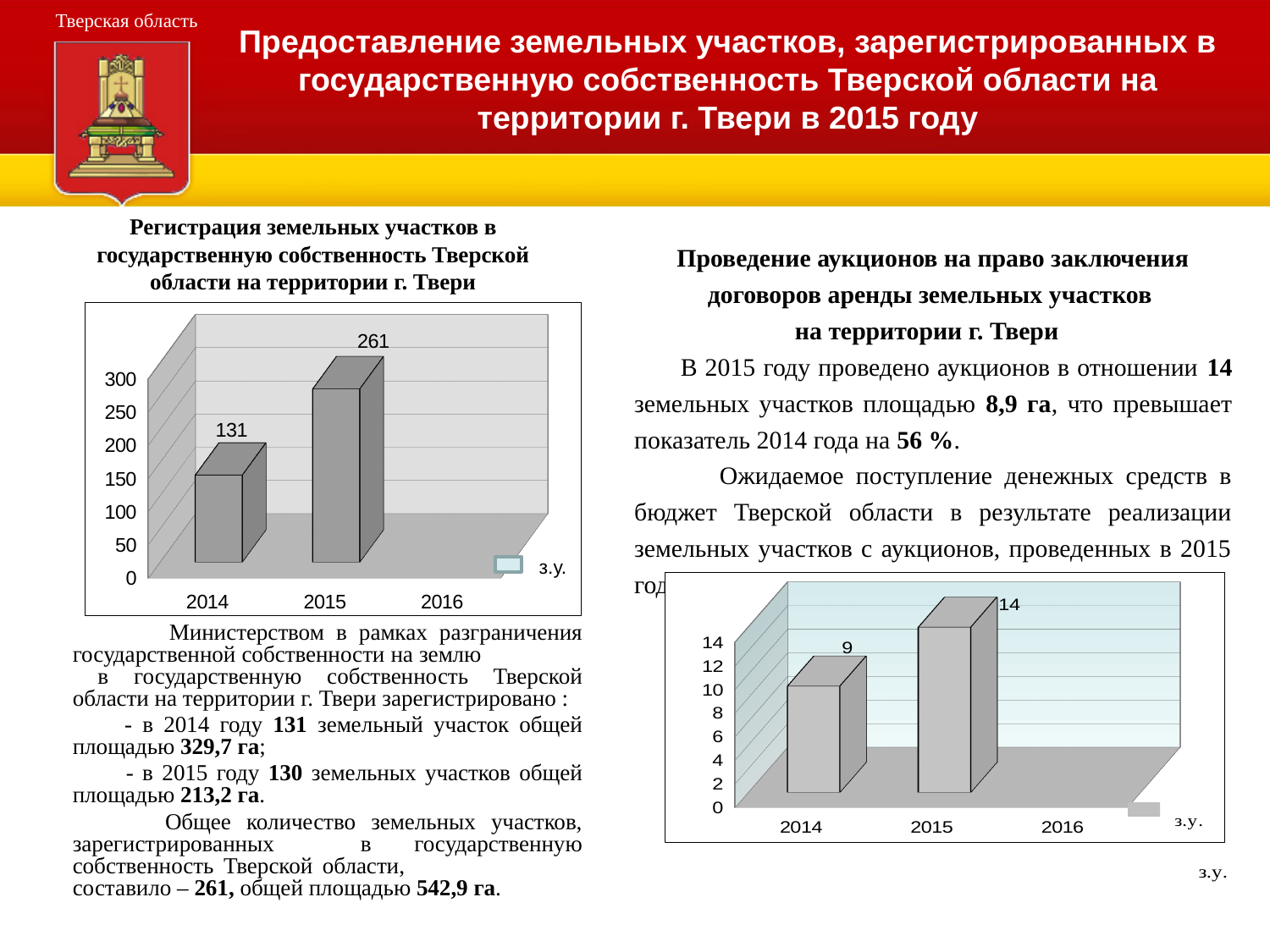
What kind of chart is the left chart? bar chart In the left chart (Регистрация земельных участков), what is the value for 2014? 131 In the bottom-right chart, what is the value for 2015? 14 In the left chart, what is the legend entry? з.у. In the left chart (Регистрация земельных участков), what is the value for 2015? 261 In the bottom-right chart, which year has the lowest plotted bar? 2014 In the left chart, is the value for 2014 greater or less than 150? less In the left chart, which year has the highest bar? 2015 In the bottom-right chart, what is the value for 2014? 9 In the left chart, what is the difference between the 2015 and 2014 values? 130 In the bottom-right chart, what is the difference between the 2015 and 2014 values? 5 In the bottom-right chart, how many bars are plotted? 2